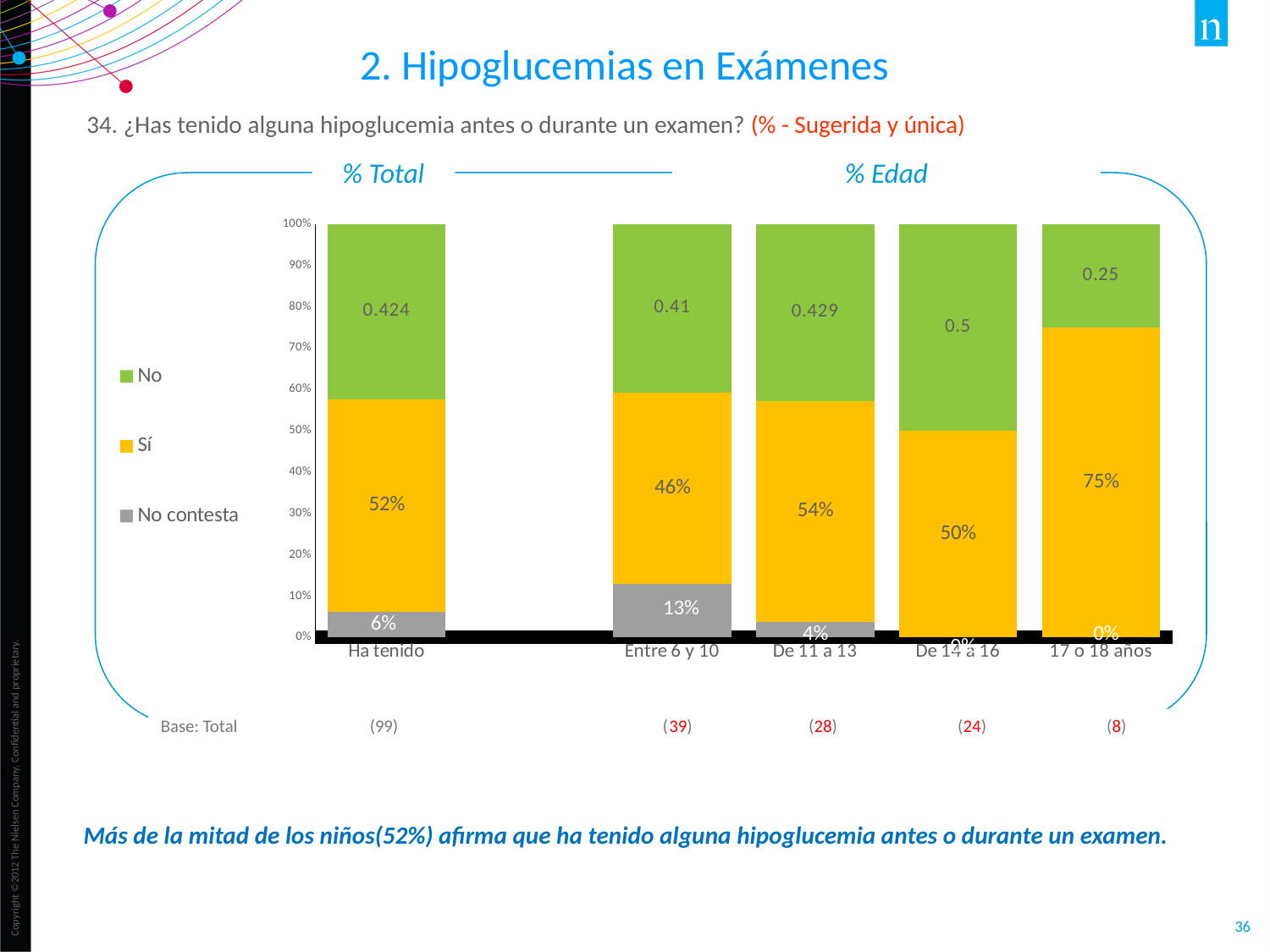
Which category has the highest value for the 'Sí' series? 17 o 18 años What is the value of the 'Sí' series for '17 o 18 años'? 75% What is the value of the 'No' series for 'De 11 a 13'? 0.429 How many series does the legend list? 3 Which is larger, the 'Sí' value for 'De 11 a 13' or for 'De 14 a 16'? De 11 a 13 What is the value of the 'No contesta' series for 'Entre 6 y 10'? 13% What is the difference between the 'Sí' values for '17 o 18 años' and 'Entre 6 y 10'? 29% What is the value of the 'Sí' series for 'Ha tenido'? 52% Which category has the lowest value for the 'No' series? 17 o 18 años How many categories are shown along the x axis? 5 What is the value of the 'No' series for 'De 14 a 16'? 0.5 What type of chart is shown on the slide? stacked bar chart